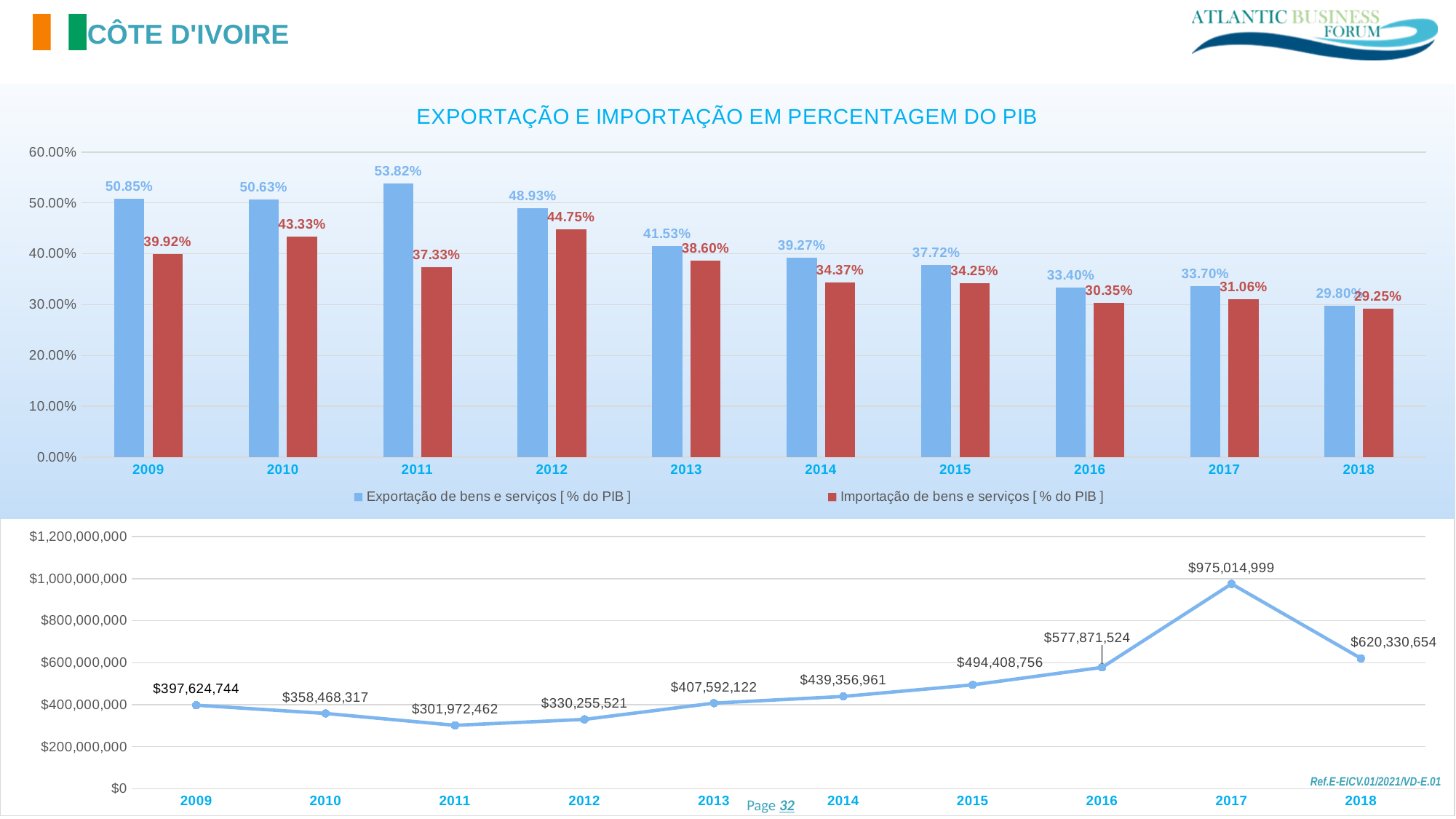
In the chart titled 'EXPORTAÇÃO E IMPORTAÇÃO EM PERCENTAGEM DO PIB', what is the value of Importação de bens e serviços for 2012? 44.75% In the chart titled 'EXPORTAÇÃO E IMPORTAÇÃO EM PERCENTAGEM DO PIB', what kind of chart is it? Bar chart In the chart titled 'EXPORTAÇÃO E IMPORTAÇÃO EM PERCENTAGEM DO PIB', what is the value of Exportação de bens e serviços for 2011? 53.82% In the line chart at the bottom of the slide, how many data points are plotted? 10 In the chart titled 'EXPORTAÇÃO E IMPORTAÇÃO EM PERCENTAGEM DO PIB', how many series does the legend list? 2 In the chart titled 'EXPORTAÇÃO E IMPORTAÇÃO EM PERCENTAGEM DO PIB', what colour are the Importação de bens e serviços bars? Red In the line chart at the bottom of the slide, is the value for 2016 larger or smaller than the value for 2018? Smaller In the chart titled 'EXPORTAÇÃO E IMPORTAÇÃO EM PERCENTAGEM DO PIB', which year has the highest Exportação de bens e serviços value? 2011 In the line chart at the bottom of the slide, which year has the lowest value? 2011 In the line chart at the bottom of the slide, what is the value for 2017? $975,014,999 In the chart titled 'EXPORTAÇÃO E IMPORTAÇÃO EM PERCENTAGEM DO PIB', what is the difference between the Exportação and Importação values for 2011? 16.49% In the chart titled 'EXPORTAÇÃO E IMPORTAÇÃO EM PERCENTAGEM DO PIB', which year has the lowest Importação de bens e serviços value? 2018